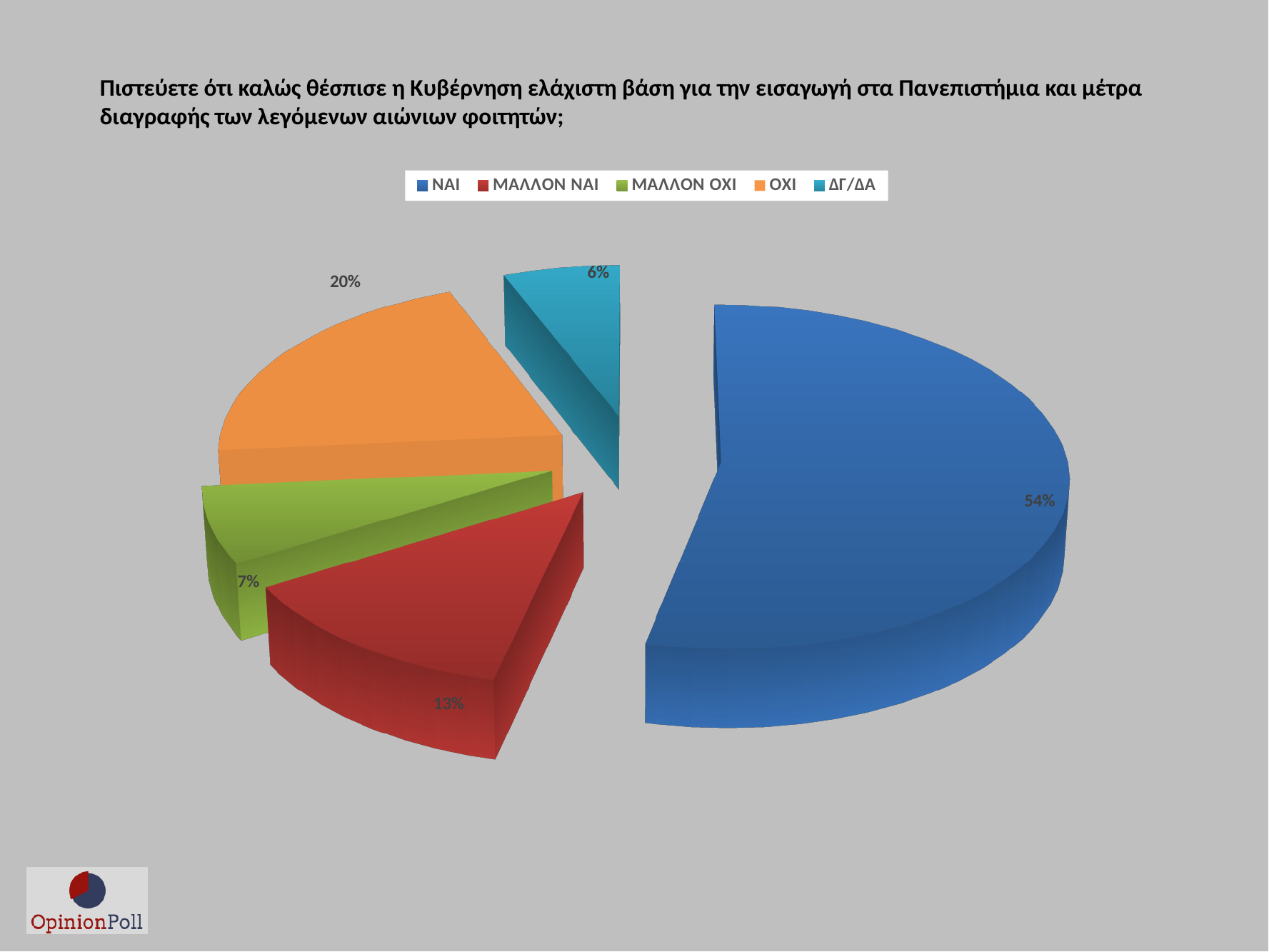
What kind of chart is shown on the slide? Pie chart Which is larger, ΜΑΛΛΟΝ ΝΑΙ or ΜΑΛΛΟΝ ΟΧΙ? ΜΑΛΛΟΝ ΝΑΙ Which category has the largest slice of the pie? ΝΑΙ What share of the pie does ΜΑΛΛΟΝ ΟΧΙ have? 7% What colour is the ΟΧΙ slice? Orange What share of the pie does ΜΑΛΛΟΝ ΝΑΙ have? 13% What share of the pie does ΟΧΙ have? 20% What is the difference in percentage points between ΝΑΙ and ΟΧΙ? 34 What share of the pie does ΔΓ/ΔΑ have? 6% Which category has the smallest slice of the pie? ΔΓ/ΔΑ How many categories does the pie chart show? 5 What share of the pie does ΝΑΙ have? 54%